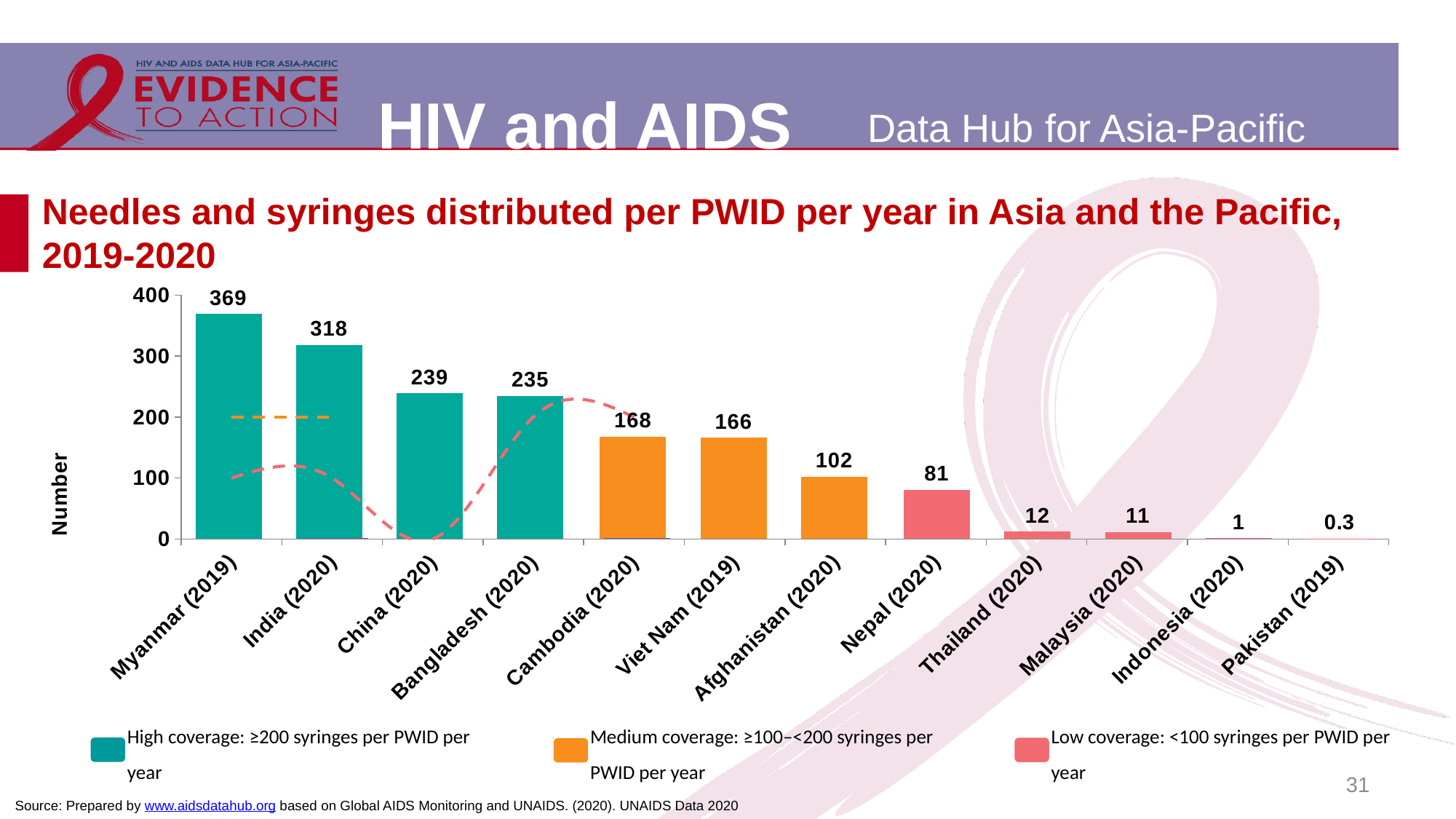
What is the value for Viet Nam (2019)? 166 What is the value for Pakistan (2019)? 0.3 Is the value for Nepal (2020) greater or less than 100? less How many coverage categories does the legend list? 3 What is the value for Myanmar (2019)? 369 What is the difference between the values for Myanmar (2019) and India (2020)? 51 What kind of chart is shown on the slide? Bar chart Which is larger, the value for Cambodia (2020) or the value for Afghanistan (2020)? Cambodia (2020) How many countries are shown on the chart? 12 Which country has the lowest number of needles and syringes distributed per PWID per year? Pakistan (2019) Which coverage category does the orange colour represent in the legend? Medium coverage: ≥100–<200 syringes per PWID per year Which country has the highest number of needles and syringes distributed per PWID per year? Myanmar (2019)